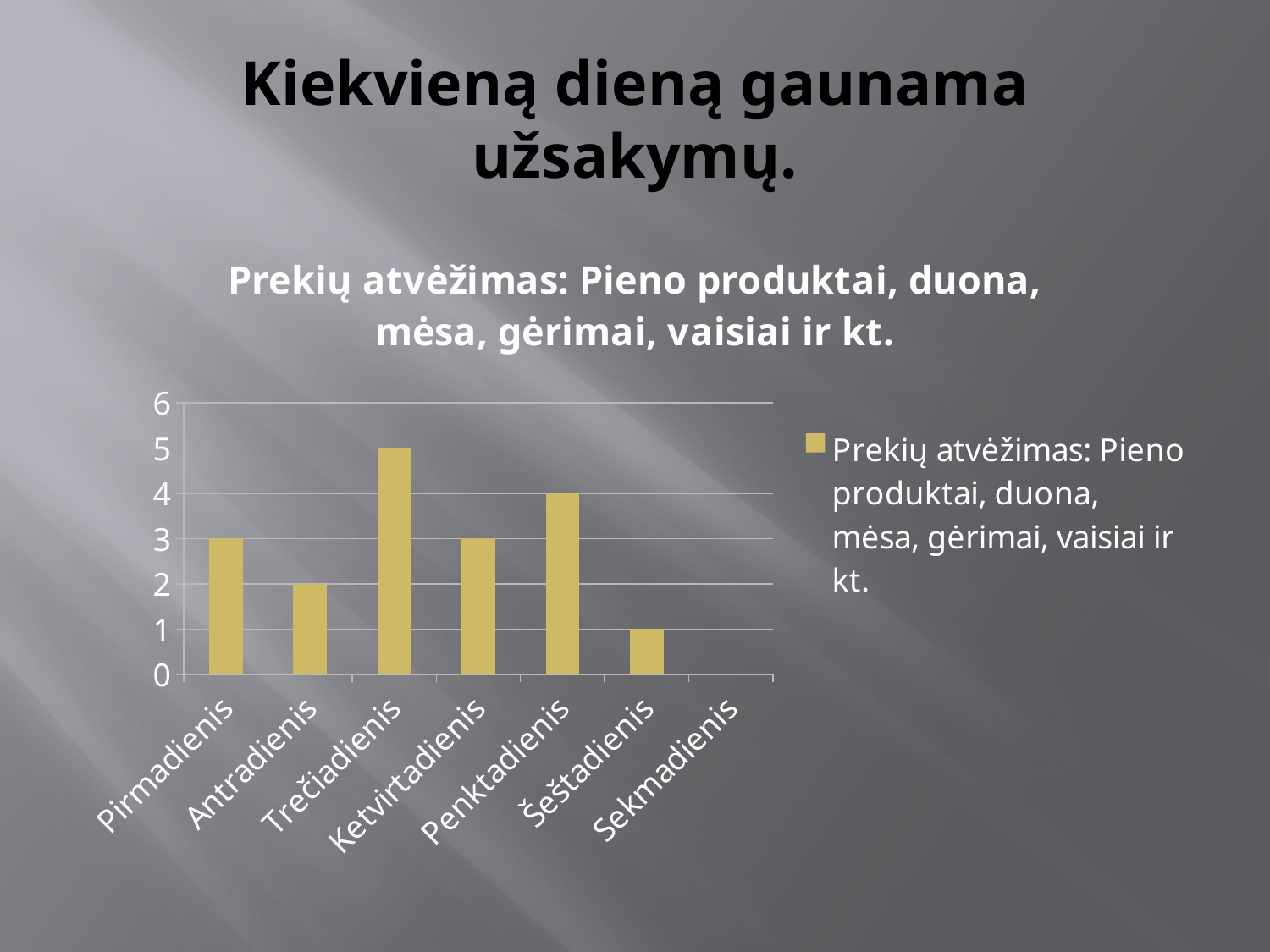
What is the value for Penktadienis? 4 Is the value for Penktadienis greater or less than 3? greater What is the value for Trečiadienis? 5 What kind of chart is shown on the slide? bar chart What is the value for Šeštadienis? 1 What is the title of the chart? Prekių atvėžimas: Pieno produktai, duona, mėsa, gėrimai, vaisiai ir kt. How many series does the legend list? 1 Which of Pirmadienis or Penktadienis has the larger value? Penktadienis How many categories are shown on the x axis? 7 Which day has the highest value? Trečiadienis What is the difference between the values for Trečiadienis and Šeštadienis? 4 What is the value for Antradienis? 2